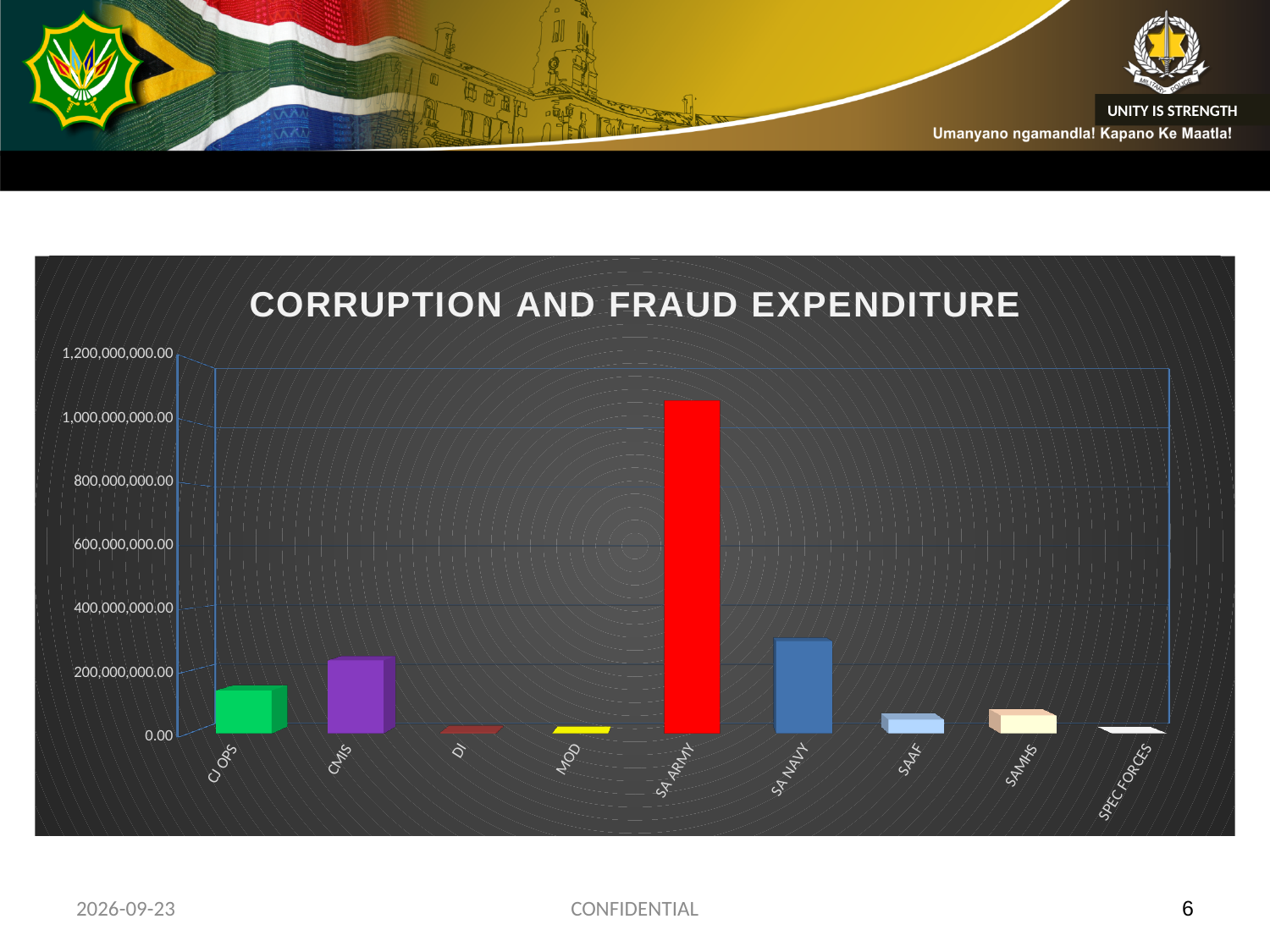
Is the value for SA NAVY greater or less than 400,000,000.00? less Is the value for SAAF greater or less than 200,000,000.00? less Which is larger, the value for SA NAVY or the value for CMIS? SA NAVY Is the value for SA ARMY greater or less than 1,000,000,000.00? greater How many categories are shown on the x axis of the chart? 9 What is the title of the chart? CORRUPTION AND FRAUD EXPENDITURE Which category has the highest value in the chart? SA ARMY What kind of chart is shown on the slide? bar chart Which is larger, the value for CJ OPS or the value for CMIS? CMIS What colour is the bar for SA ARMY? red